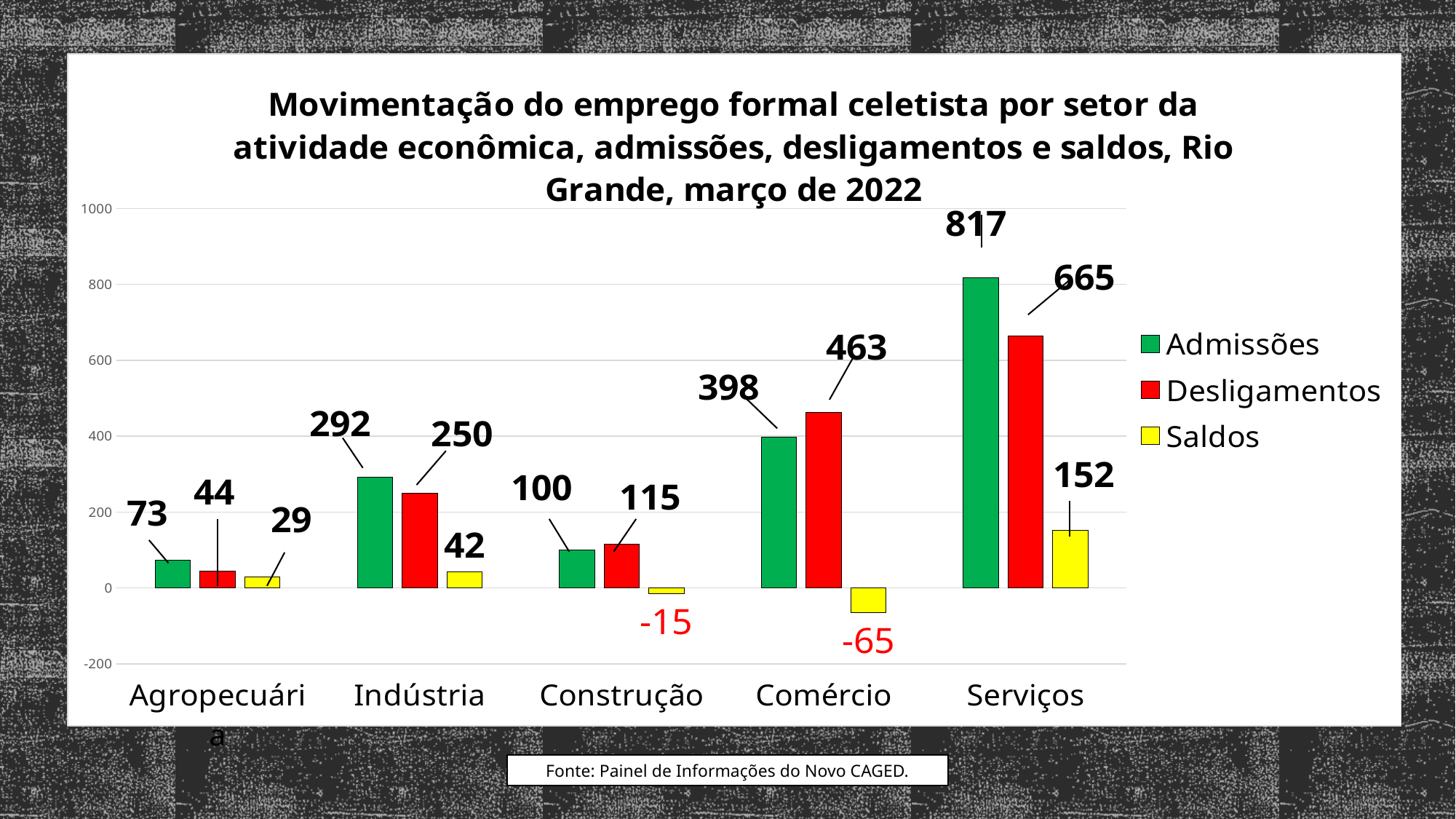
What is the value of Desligamentos for Comércio? 463 What is the value of Admissões for Serviços? 817 What is the difference between Admissões and Desligamentos for Indústria? 42 Is the Desligamentos value for Serviços greater or less than 600? greater What is the value of Saldos for Construção? -15 What colour represents the Saldos series? Yellow Which sector has the highest Admissões value? Serviços Which is larger for Comércio, Admissões or Desligamentos? Desligamentos How many sectors are shown on the x axis? 5 What kind of chart is shown on the slide? Bar chart Which sector has the lowest Saldos value? Comércio How many series does the legend list? 3